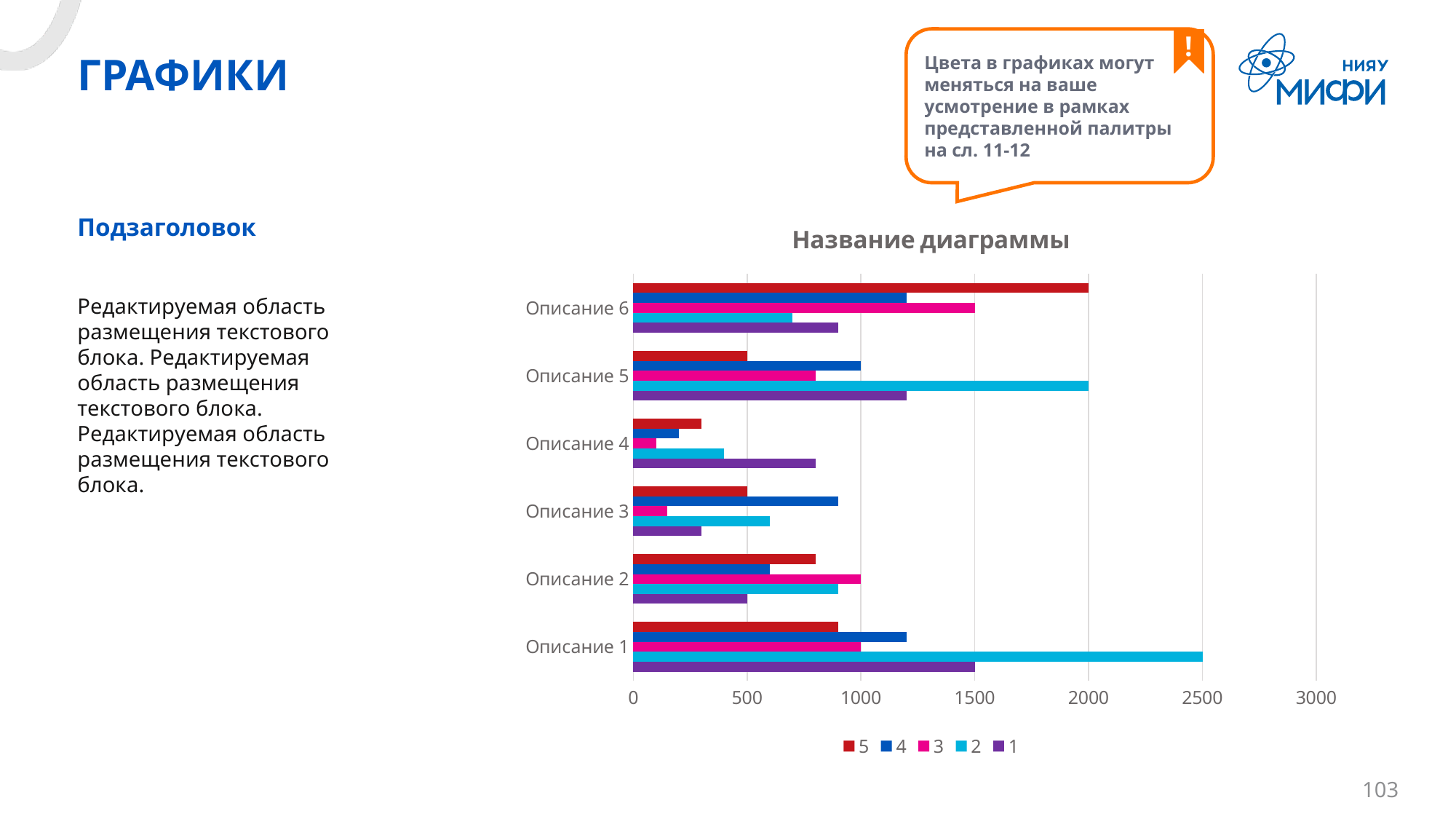
What is the value of series 2 for Описание 5? 2000 What is the value of series 2 for Описание 1? 2500 What is the title of the chart? Название диаграммы Which series has the highest value for Описание 4? 1 What is the value of series 1 for Описание 2? 500 Which is larger for Описание 5: series 2 or series 5? series 2 Which series has the highest value for Описание 1? 2 What kind of chart is shown on the slide? bar chart How many series does the legend list? 5 How many categories are shown on the chart? 6 Is the value of series 4 for Описание 6 greater or less than 1000? greater What is the value of series 5 for Описание 6? 2000